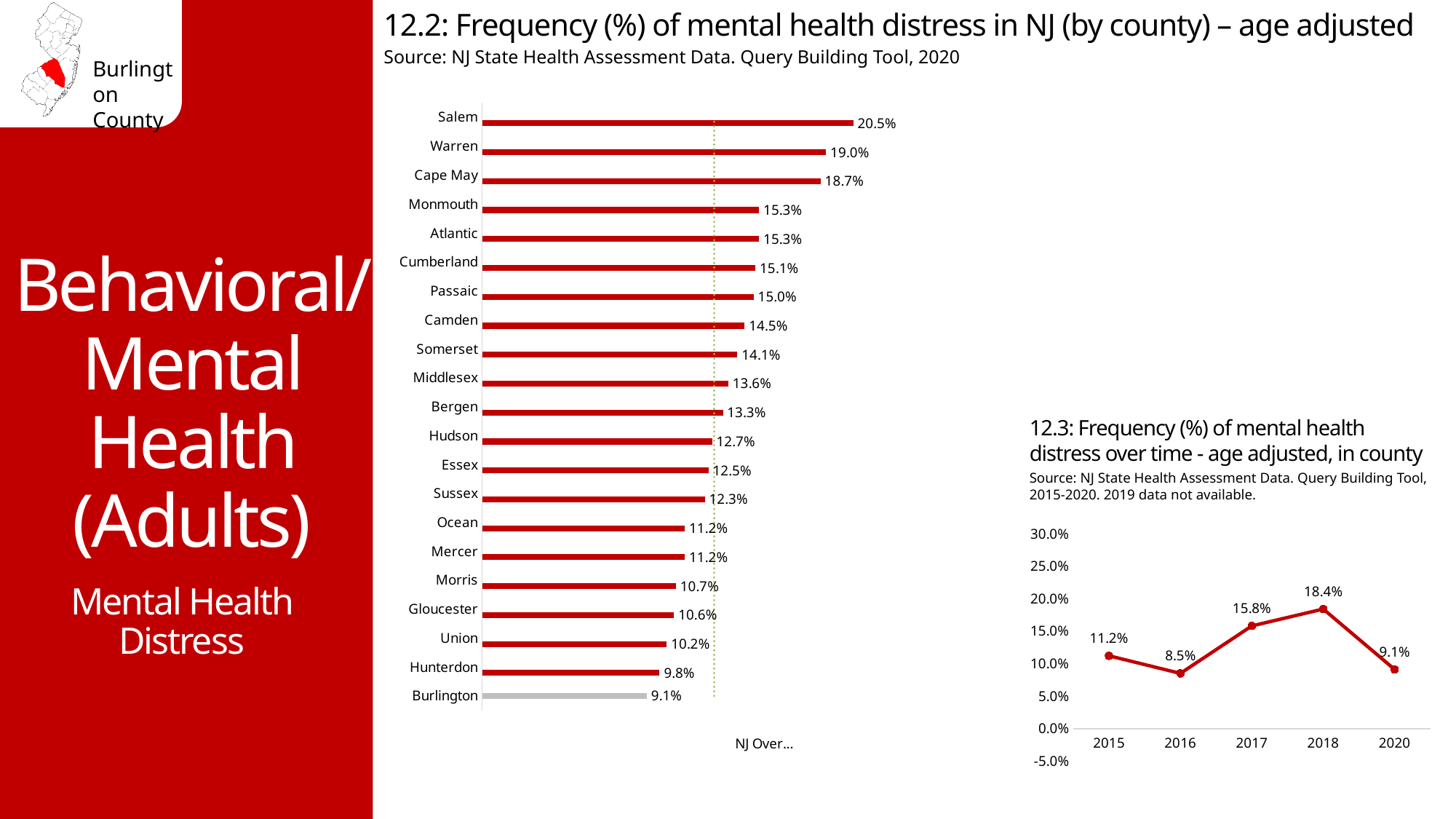
In chart 12.2 (by county), which is larger, Camden or Somerset? Camden In chart 12.2 (by county), which county has the lowest value? Burlington In chart 12.2 (by county), what is the value for Salem? 20.5% In chart 12.2 (by county), what is the difference between Salem and Burlington? 11.4% In chart 12.3 (over time), what is the difference between 2018 and 2020? 9.3% In chart 12.2 (by county), how many counties are shown? 21 In chart 12.3 (over time), what is the value for 2018? 18.4% In chart 12.3 (over time), which year has the lowest value? 2016 What kind of chart is chart 12.2 (by county)? Bar chart In chart 12.2 (by county), what is the value for Burlington? 9.1% What kind of chart is chart 12.3 (over time)? Line chart In chart 12.2 (by county), which county has the highest value? Salem